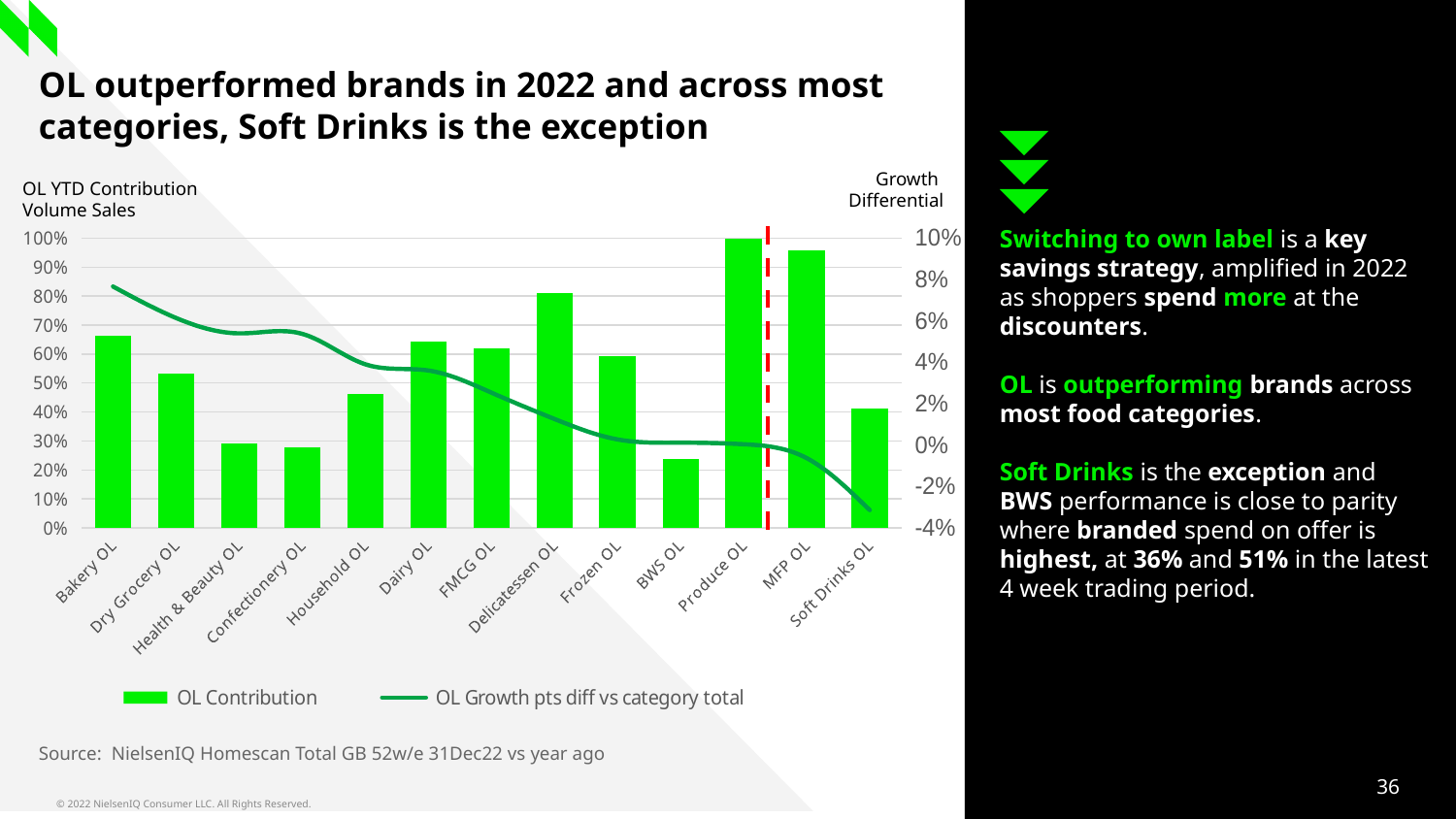
What kind of chart is used to show OL Contribution on this slide? bar chart Does the OL Growth pts diff vs category total line rise or fall from Bakery OL to Soft Drinks OL? fall Which has the larger OL Contribution, Dairy OL or Household OL? Dairy OL Is the OL Contribution for Health & Beauty OL greater or less than 40%? less How many categories are shown along the x axis of the chart? 13 Which category has the highest OL Contribution bar? Produce OL How many series does the chart legend list? 2 Is the OL Contribution for Delicatessen OL greater or less than 70%? greater Is the OL Growth pts diff vs category total for Soft Drinks OL greater or less than 0%? less What is the name of the line series in the chart legend? OL Growth pts diff vs category total Which category has the lowest OL Contribution bar? BWS OL